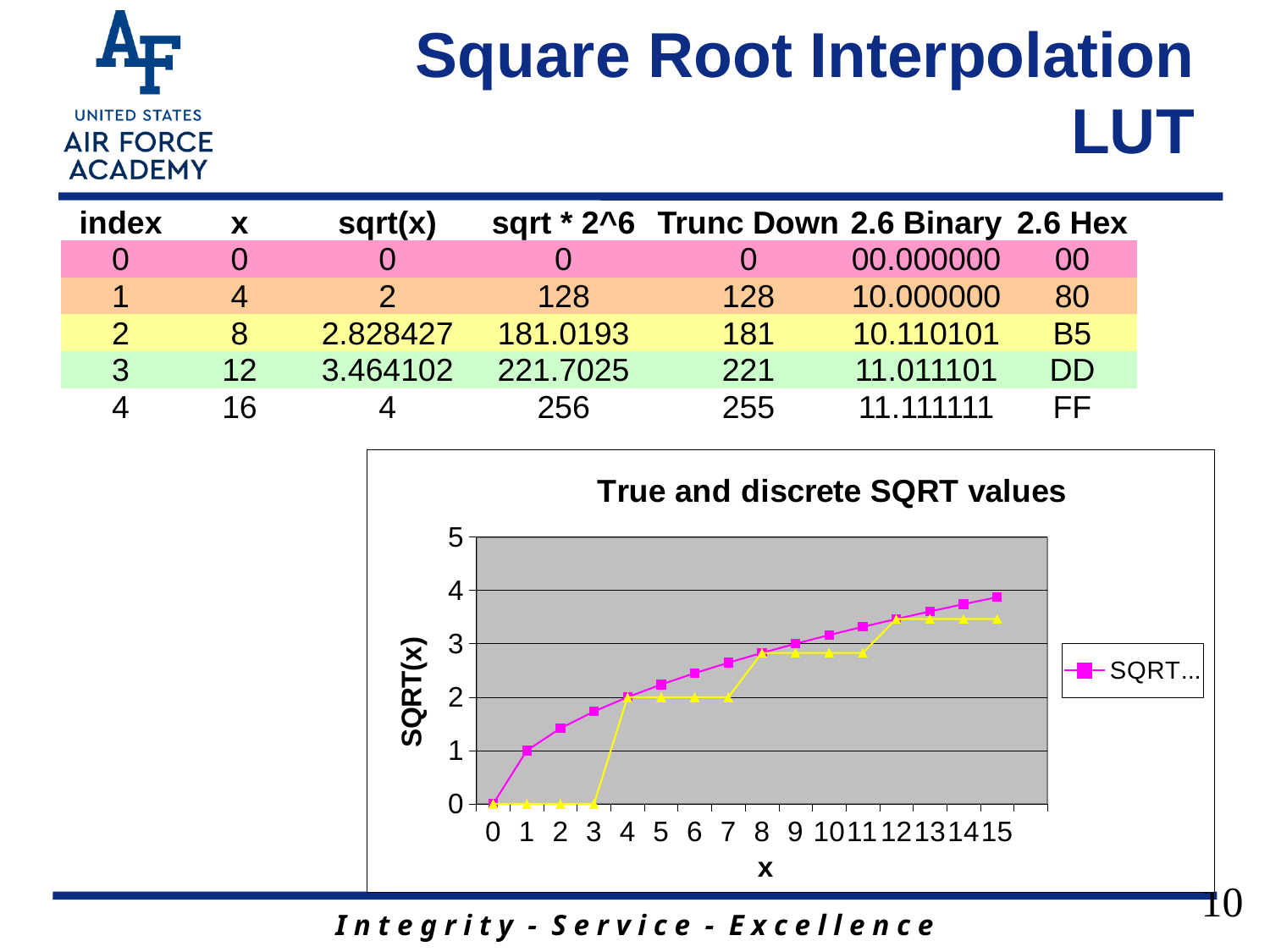
Is the value of the magenta line at x = 15 greater or less than 3? greater What is the value of the magenta (square-marker) line at x = 4? 2 Is the value of the yellow line at x = 10 greater or less than 3? less At x = 10, which line has the higher value, the magenta line or the yellow line? magenta line What is the value of the yellow (triangle-marker) line at x = 3? 0 What is the value of the yellow (triangle-marker) line at x = 6? 2 What is the title of the chart? True and discrete SQRT values How many x-axis points are plotted on the chart (from 0 to 15)? 16 What is the label on the vertical axis of the chart? SQRT(x) Do the values of the magenta line rise or fall as x increases from 0 to 15? rise What is the value of the magenta (square-marker) line at x = 1? 1 What kind of chart is shown on the slide? line chart